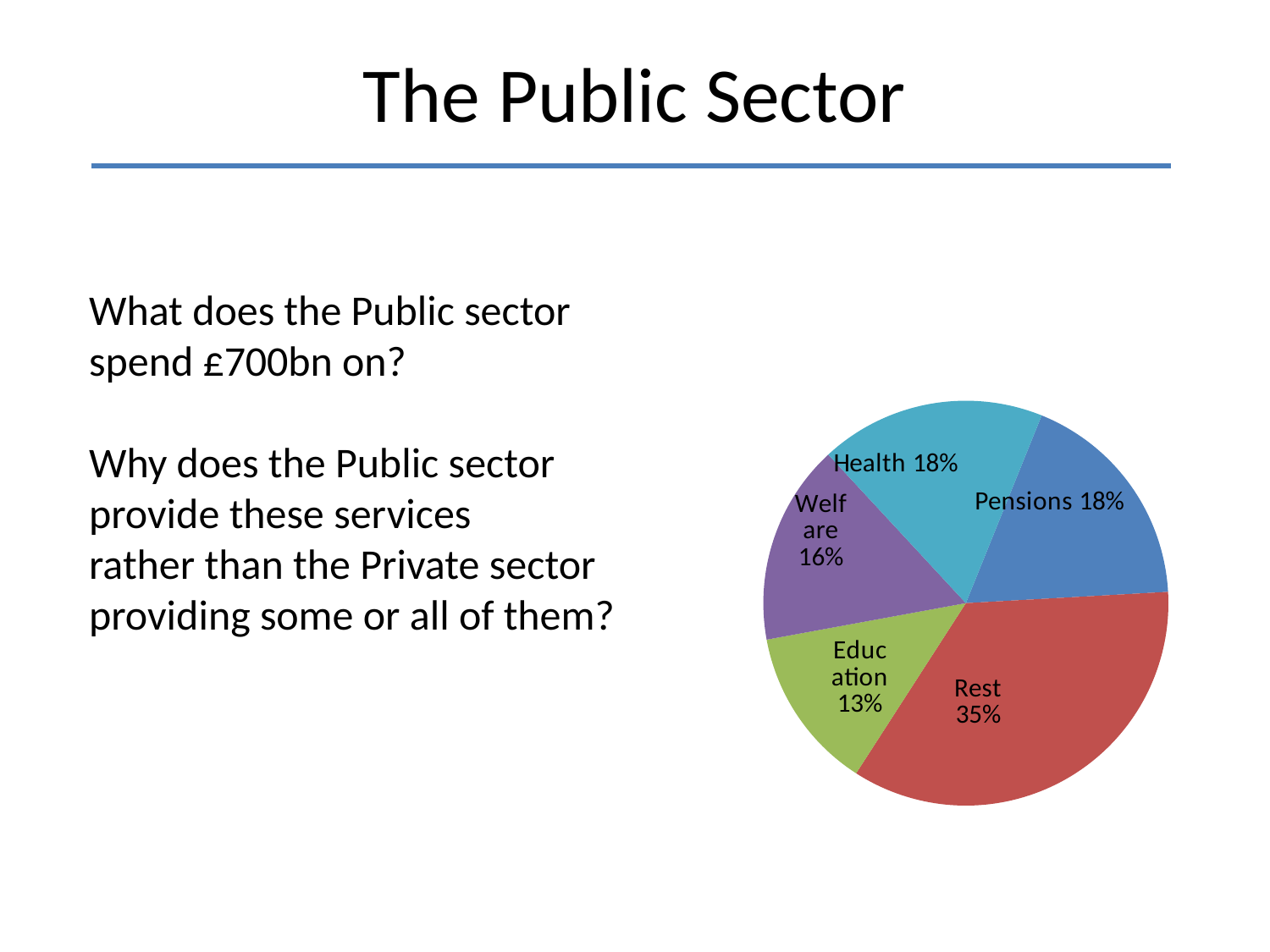
What kind of chart is shown on the slide? Pie chart What share of the pie does Rest account for? 35% What share of the pie does Health account for? 18% Which slice of the pie is the largest? Rest How many slices does the pie chart have? 5 What is the difference in percentage points between Rest and Welfare? 19 What share of the pie does Pensions account for? 18% Which is larger, Welfare or Education? Welfare Which slice of the pie is the smallest? Education What is the difference in percentage points between Health and Education? 5